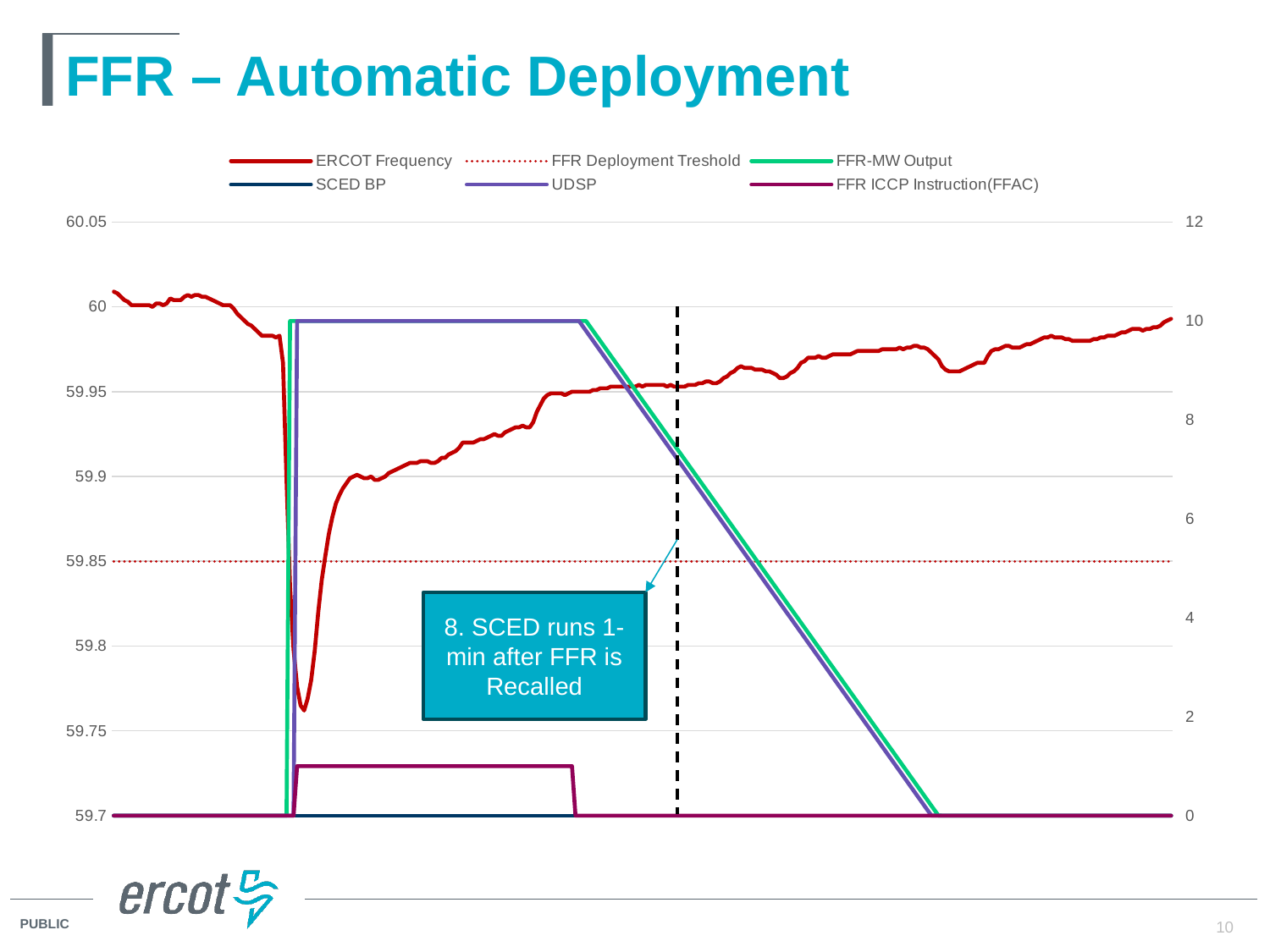
What kind of chart is shown on the slide? line chart What value on the right axis does the FFR-MW Output plateau reach? 10 At what frequency value is the FFR Deployment Treshold line drawn on the left axis? 59.85 After its sharp dip, does the ERCOT Frequency line generally rise or fall toward the right of the chart? rise Is the FFR-MW Output plateau greater or less than 8 on the right axis? greater What does the text box on the chart say? 8. SCED runs 1-min after FFR is Recalled Is the peak of the FFR ICCP Instruction(FFAC) line greater or less than 2 on the right axis? less Is the lowest point of the ERCOT Frequency line greater or less than 59.8? less How many series does the legend list? 6 What is the title of the slide? FFR – Automatic Deployment Which reaches a higher peak on the right axis, FFR-MW Output or FFR ICCP Instruction(FFAC)? FFR-MW Output